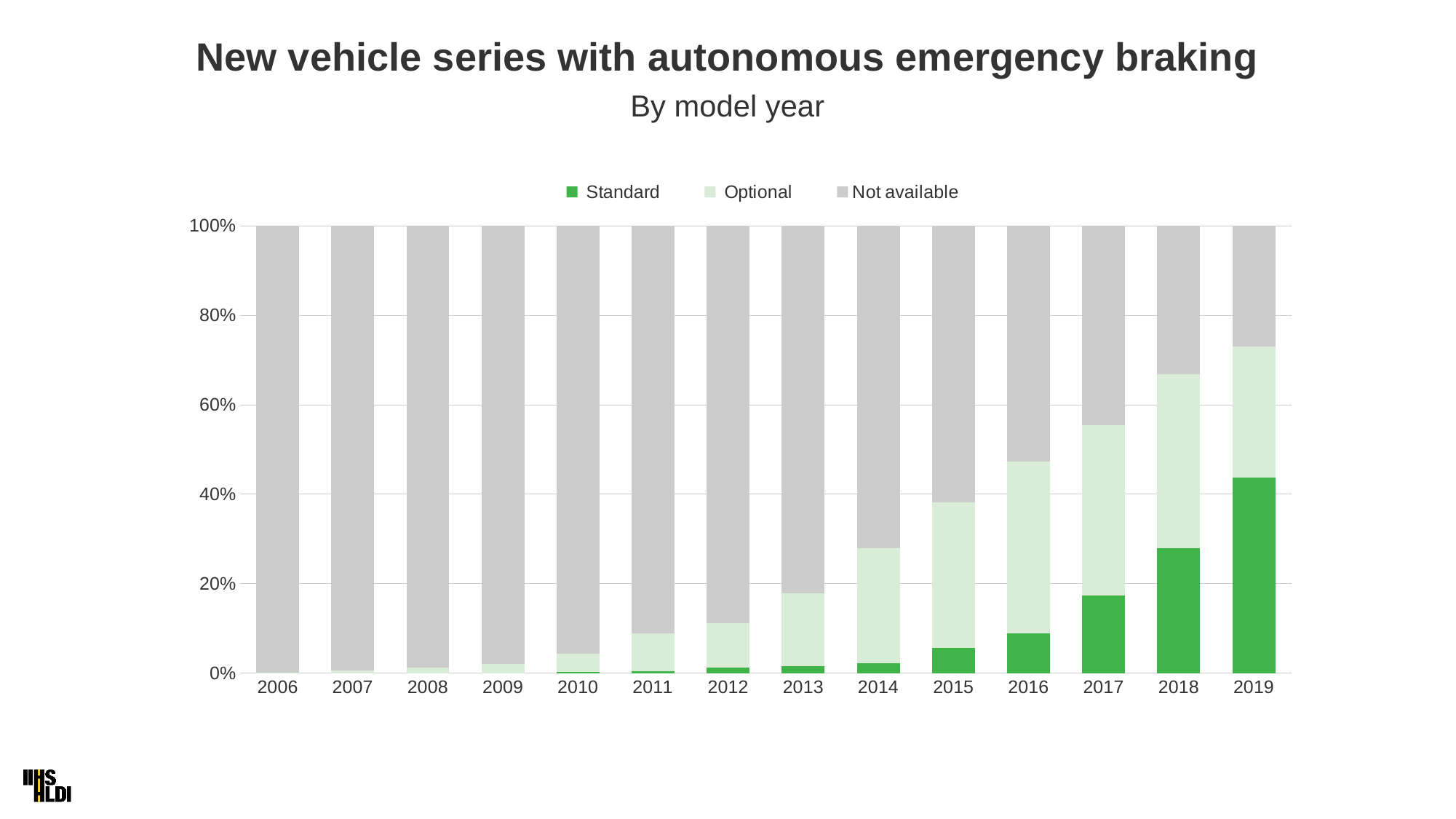
Is the Not available value for 2019 greater or less than 40%? less Which is larger, the Standard share for 2018 or for 2017? 2018 Is the Not available value for 2014 greater or less than 60%? greater Which model year has the lowest share of Not available? 2019 Is the Standard value for 2019 greater or less than 40%? greater How many series does the legend list? 3 What kind of chart is shown on the slide? Stacked bar chart How many model years are shown on the x axis? 14 Which model year has the highest share of Standard autonomous emergency braking? 2019 What is the total of the stacked bar for 2010? 100% Does the Standard share rise or fall from 2006 to 2019? rise